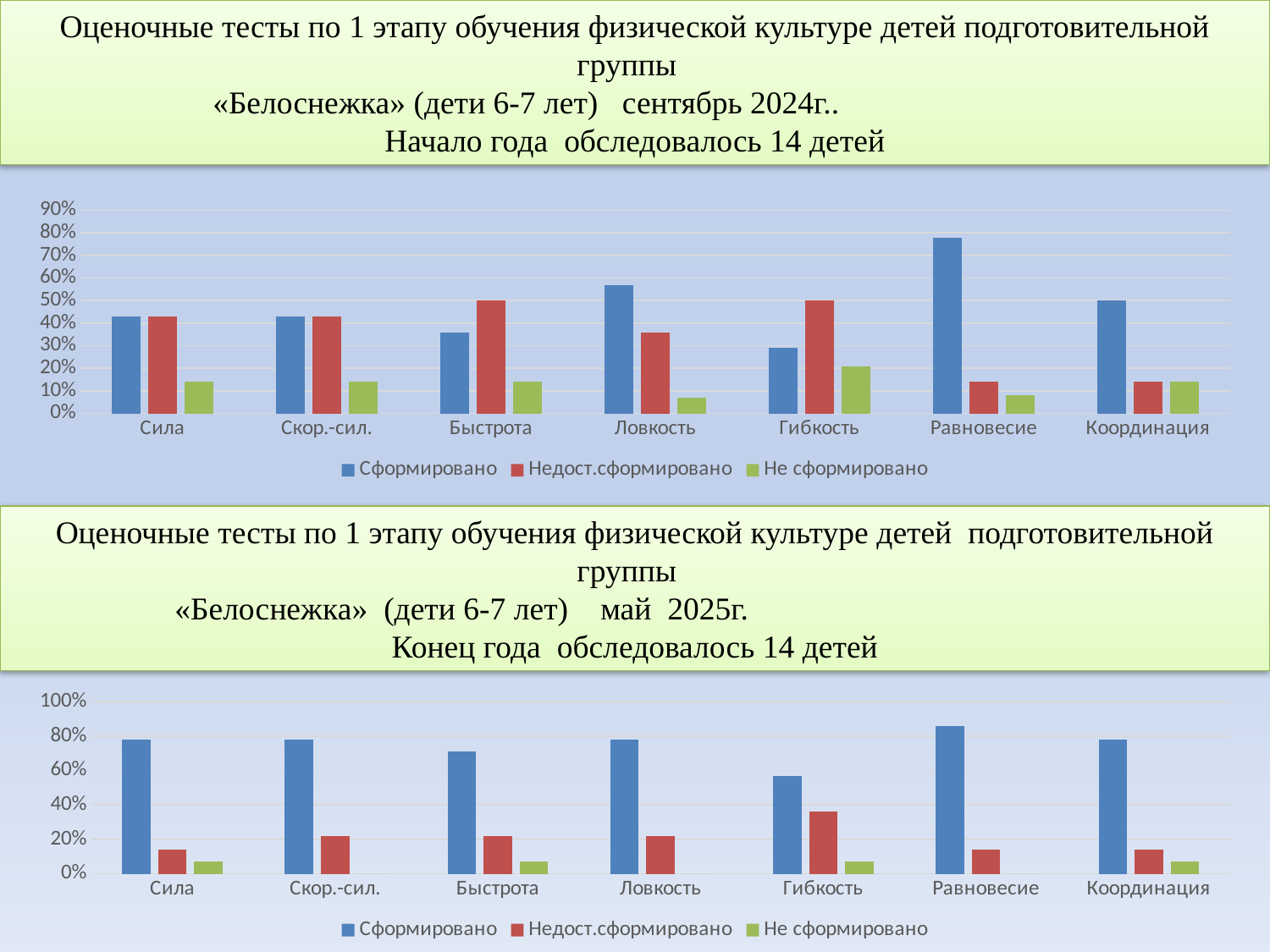
How many categories are shown on the x axis of the top chart (сентябрь 2024г.)? 7 How many series does the legend of the top chart (сентябрь 2024г.) list? 3 What kind of chart is the top chart (сентябрь 2024г.)? bar chart In the top chart (сентябрь 2024г.), is the value for Сформировано in Ловкость greater or less than 40%? greater In the top chart (сентябрь 2024г.), which category has the highest value for Сформировано? Равновесие What are the legend entries of the bottom chart (май 2025г.)? Сформировано, Недост.сформировано, Не сформировано In the bottom chart (май 2025г.), which category has the lowest value for Сформировано? Гибкость In the top chart (сентябрь 2024г.), is the value for Сформировано in Равновесие greater or less than 70%? greater In the top chart (сентябрь 2024г.), is the value for Не сформировано in Гибкость greater or less than 10%? greater In the bottom chart (май 2025г.), which category has the highest value for Сформировано? Равновесие In the top chart (сентябрь 2024г.), for Гибкость, which is larger: Сформировано or Недост.сформировано? Недост.сформировано